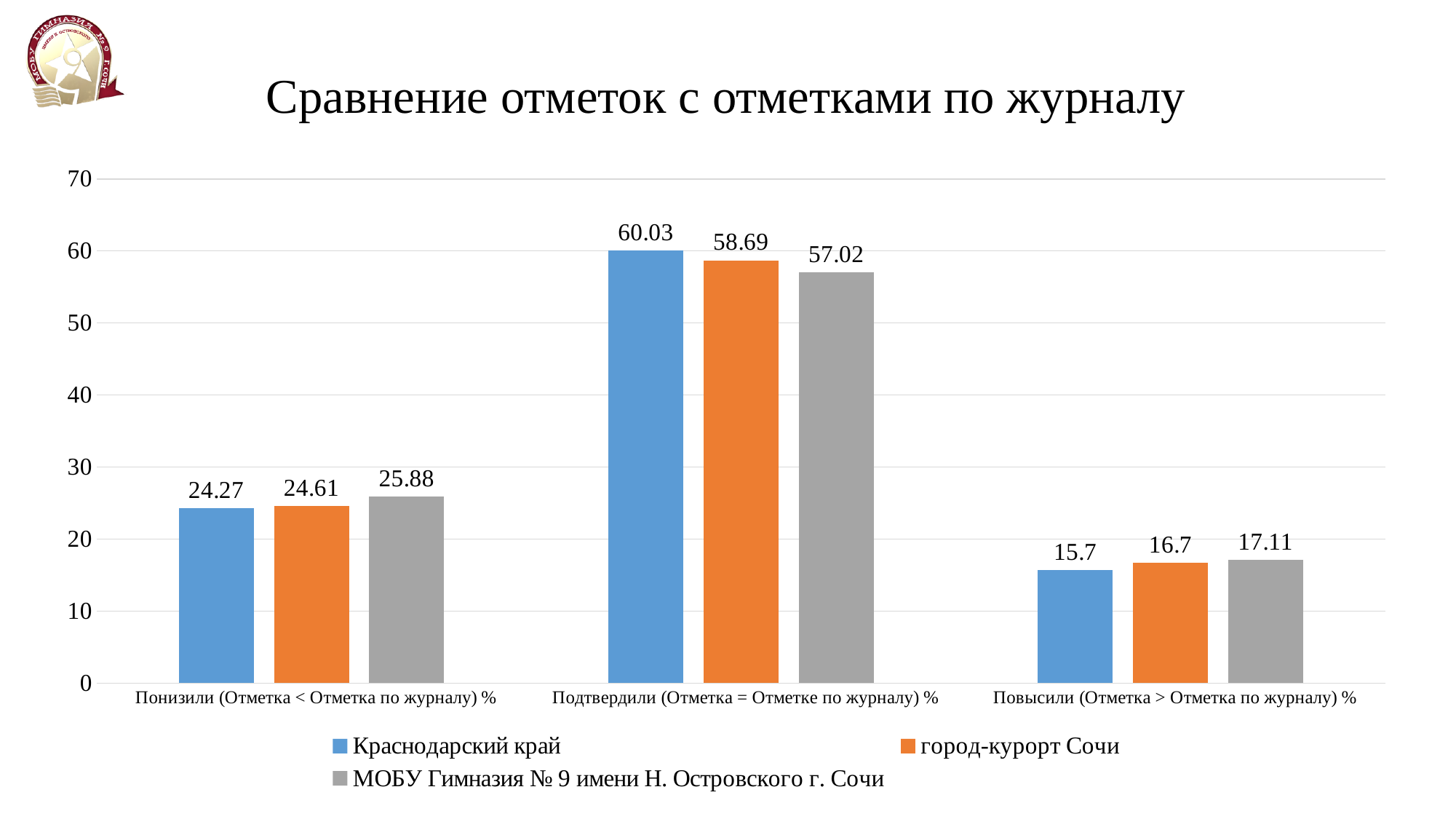
What is the value for Краснодарский край in the Подтвердили (Отметка = Отметке по журналу) % category? 60.03 What is the value for город-курорт Сочи in the Повысили (Отметка > Отметка по журналу) % category? 16.7 In the Подтвердили (Отметка = Отметке по журналу) % category, which is larger: Краснодарский край or город-курорт Сочи? Краснодарский край Which category has the lowest value for МОБУ Гимназия № 9 имени Н. Островского г. Сочи? Повысили (Отметка > Отметка по журналу) % What is the difference between the Краснодарский край and МОБУ Гимназия № 9 values in the Подтвердили (Отметка = Отметке по журналу) % category? 3.01 Which category has the highest value for Краснодарский край? Подтвердили (Отметка = Отметке по журналу) % How many series does the legend list? 3 What is the value for МОБУ Гимназия № 9 имени Н. Островского г. Сочи in the Понизили (Отметка < Отметка по журналу) % category? 25.88 What is the difference between the МОБУ Гимназия № 9 and Краснодарский край values in the Повысили (Отметка > Отметка по журналу) % category? 1.41 Is the value for город-курорт Сочи in the Понизили (Отметка < Отметка по журналу) % category greater or less than 30? less How many categories are shown on the x axis? 3 What kind of chart is shown on the slide? bar chart